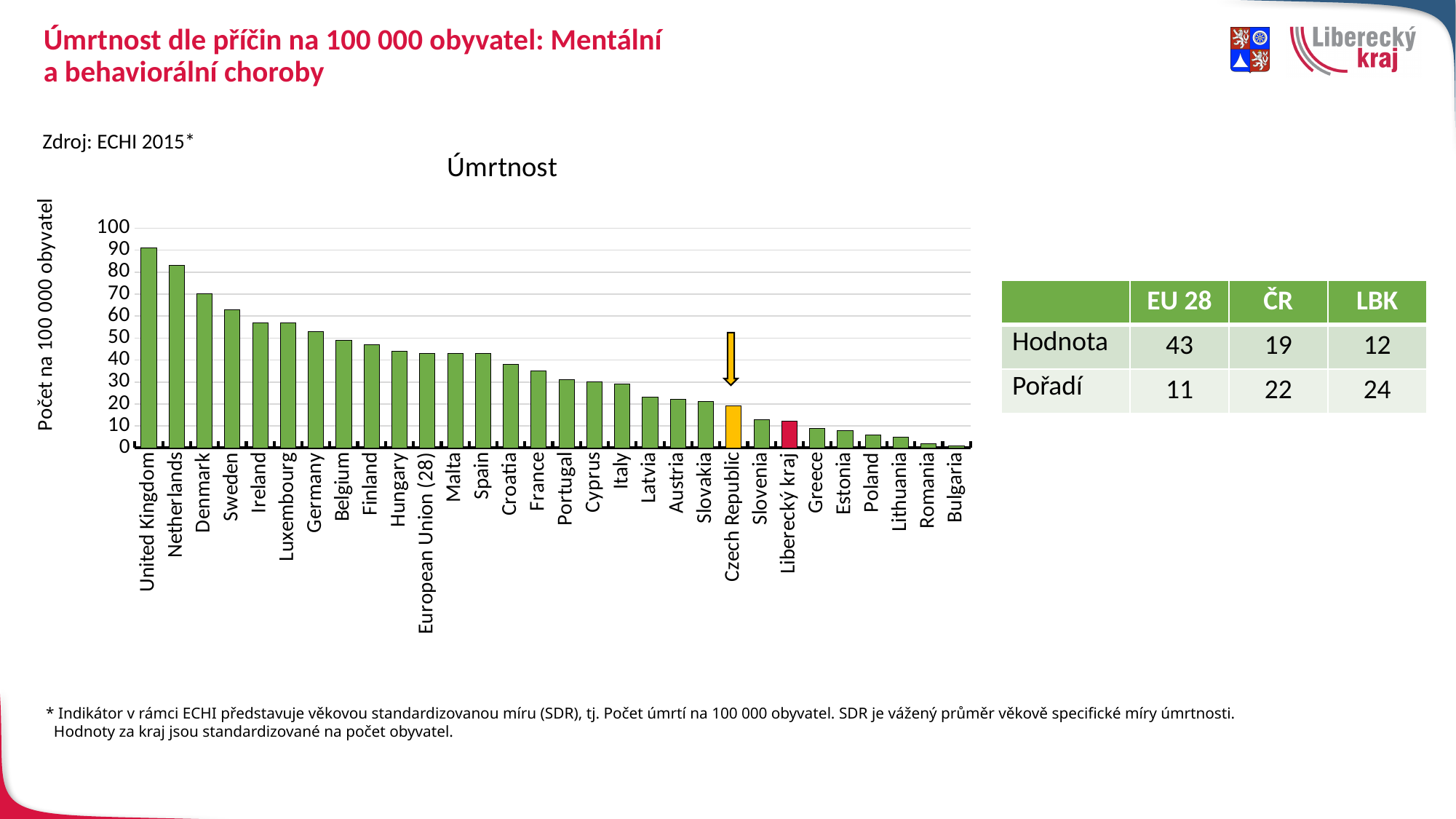
Which category has the highest value in the chart? United Kingdom What is the value for Czech Republic (ČR) according to the table on the slide? 19 What is the difference between the EU 28 value and the ČR value shown in the table? 24 What colour is the bar for Czech Republic in the chart? orange Which has the larger value, Netherlands or Denmark? Netherlands What kind of chart is shown on the slide? bar chart Is the value for United Kingdom greater or less than 80? greater What is the value for Liberecký kraj (LBK) according to the table on the slide? 12 How many countries/regions are plotted on the x axis of the chart? 30 Do the values rise or fall moving from left to right along the x axis? fall Is the value for France greater or less than 40? less What is the value for European Union (28) according to the table on the slide? 43